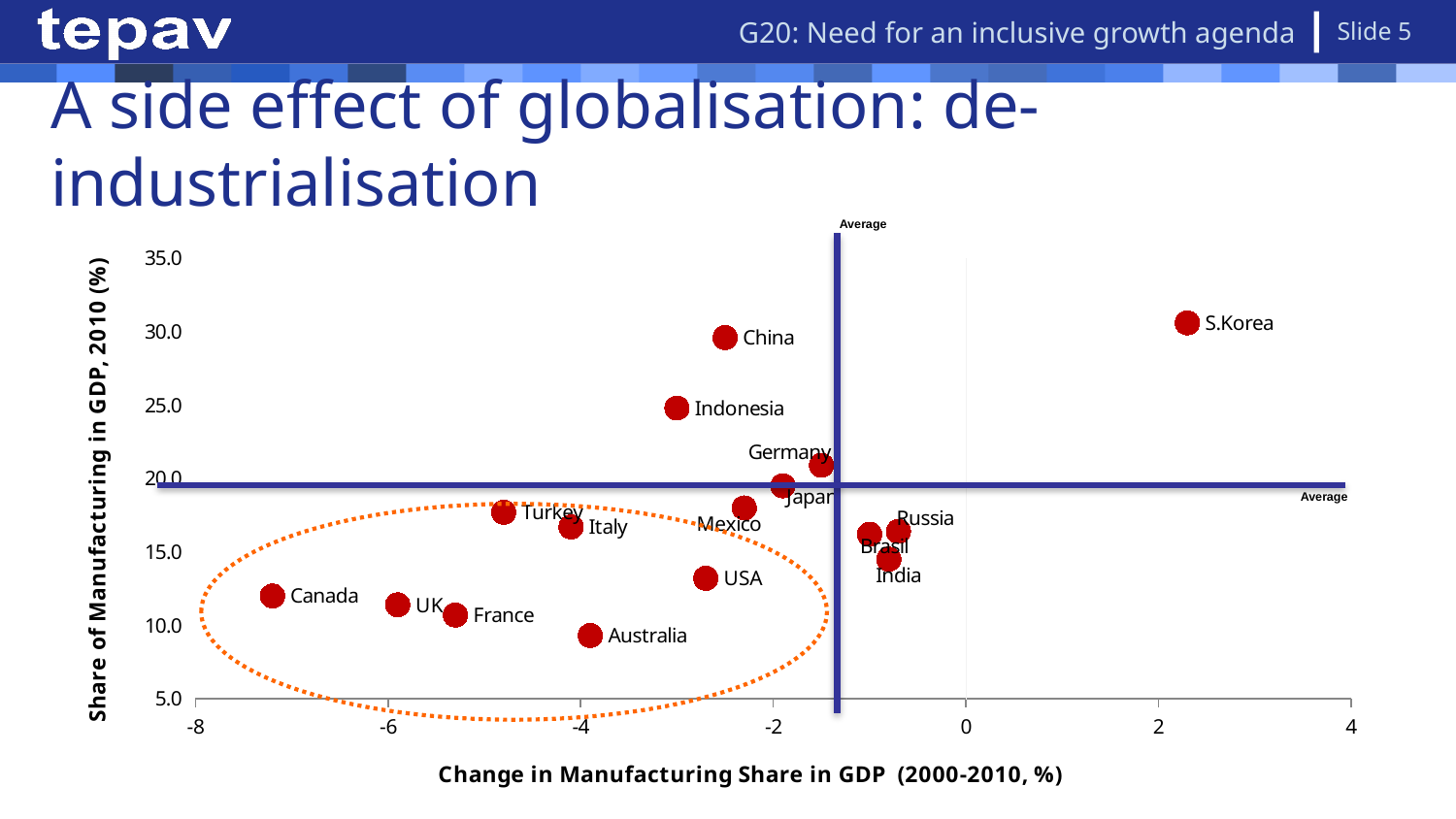
Is the share of manufacturing in GDP for Canada greater or less than 15.0? less Which country has the lowest share of manufacturing in GDP in 2010 on the chart? Australia Is the share of manufacturing in GDP for Indonesia greater or less than 20.0? greater Which country has the lowest change in manufacturing share in GDP (2000-2010) on the chart? Canada Which country has a higher share of manufacturing in GDP, Indonesia or USA? Indonesia Which country has the highest change in manufacturing share in GDP (2000-2010) on the chart? S.Korea What is the title of the x axis of the chart? Change in Manufacturing Share in GDP (2000-2010, %) Is the share of manufacturing in GDP for China greater or less than 25.0? greater How many countries are plotted on the chart? 16 What kind of chart is shown on the slide? scatter chart Which country has a higher change in manufacturing share in GDP, Canada or UK? UK